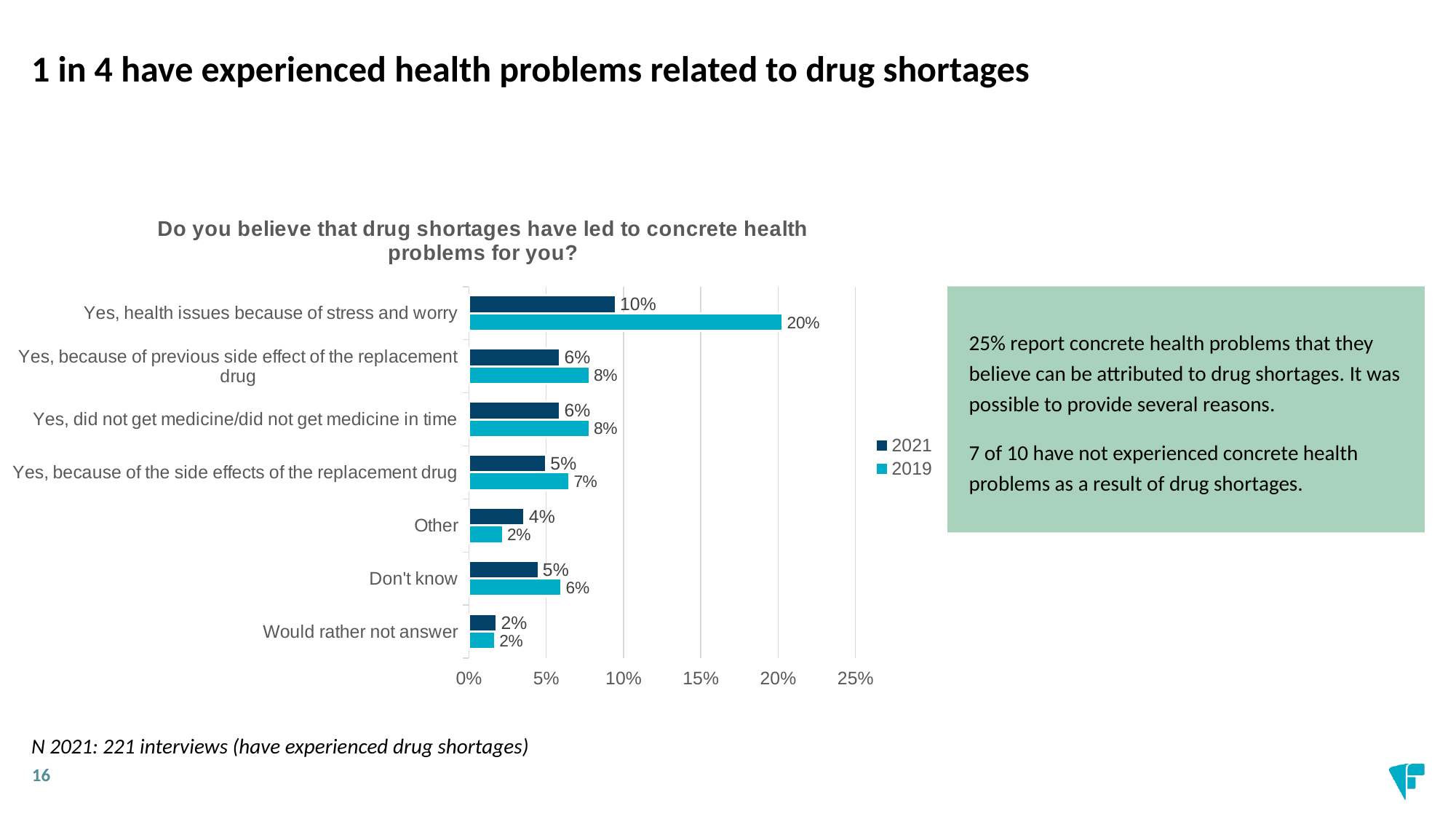
For "Other", which year has the larger value, 2021 or 2019? 2021 How many categories are shown on the chart? 7 How many series does the legend list? 2 What is the difference between the 2019 and 2021 values for "Yes, health issues because of stress and worry"? 10% What is the title of the chart? Do you believe that drug shortages have led to concrete health problems for you? What is the 2021 value for "Don't know"? 5% Which category has the lowest 2021 value? Would rather not answer What is the 2021 value for "Other"? 4% Which category has the highest 2019 value? Yes, health issues because of stress and worry Is the 2019 value for "Yes, health issues because of stress and worry" greater or less than 15%? greater What kind of chart is shown on the slide? Bar chart What is the 2019 value for "Yes, health issues because of stress and worry"? 20%